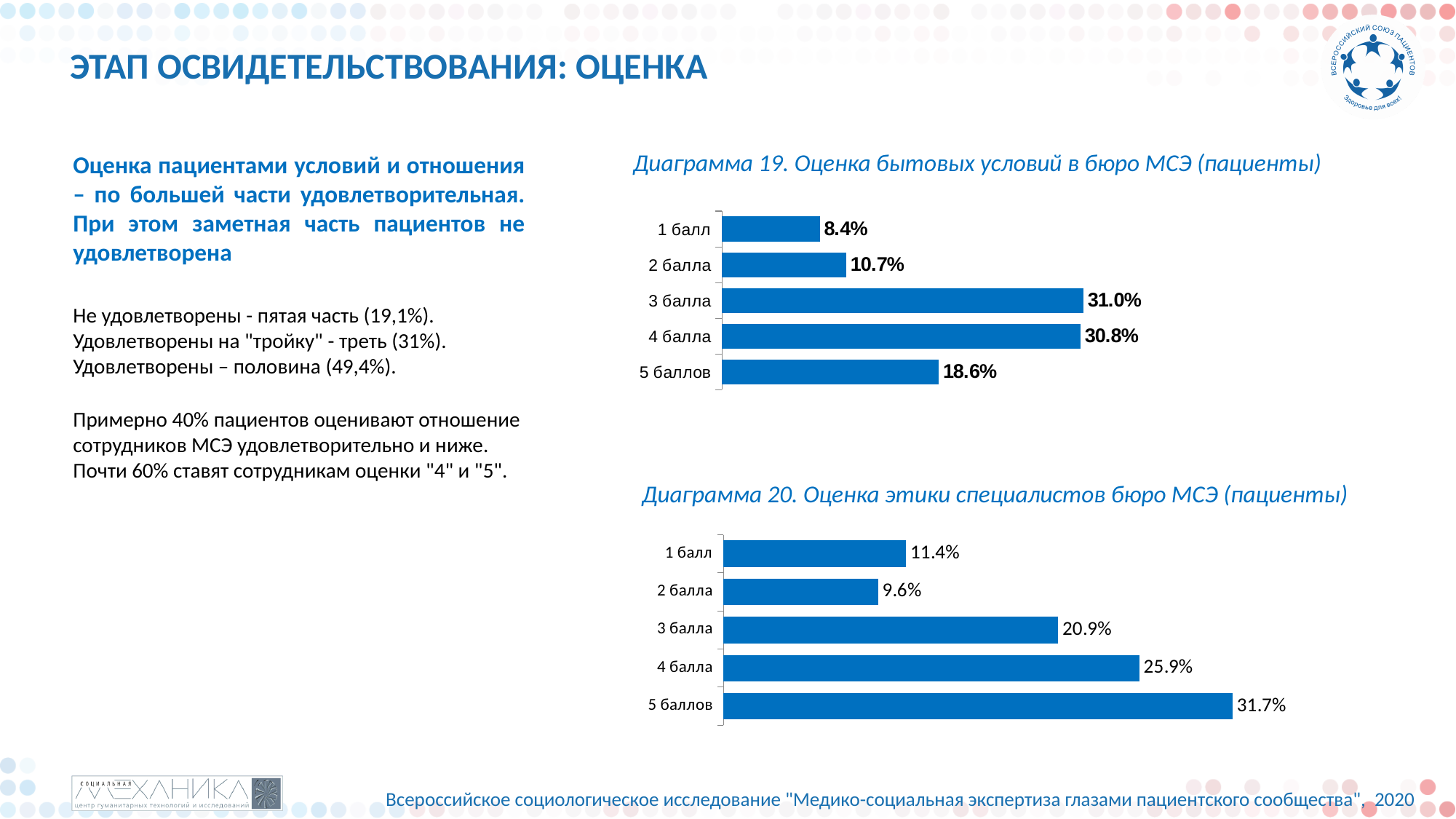
In Диаграмма 20 (Оценка этики специалистов бюро МСЭ), which category has the highest value? 5 баллов In Диаграмма 20 (Оценка этики специалистов бюро МСЭ), what is the value for 4 балла? 25.9% In Диаграмма 19 (Оценка бытовых условий в бюро МСЭ), what is the value for 3 балла? 31.0% In Диаграмма 19 (Оценка бытовых условий в бюро МСЭ), what is the difference between the values for 2 балла and 1 балл? 2.3% In Диаграмма 20 (Оценка этики специалистов бюро МСЭ), what is the value for 2 балла? 9.6% In Диаграмма 20 (Оценка этики специалистов бюро МСЭ), which category has the lowest value? 2 балла What type of chart is Диаграмма 19 (Оценка бытовых условий в бюро МСЭ)? Bar chart In Диаграмма 20 (Оценка этики специалистов бюро МСЭ), what is the difference between the values for 5 баллов and 4 балла? 5.8% In Диаграмма 19 (Оценка бытовых условий в бюро МСЭ), what is the value for 5 баллов? 18.6% In Диаграмма 20 (Оценка этики специалистов бюро МСЭ), which is larger: the value for 3 балла or the value for 1 балл? 3 балла In Диаграмма 19 (Оценка бытовых условий в бюро МСЭ), how many categories are shown? 5 In Диаграмма 19 (Оценка бытовых условий в бюро МСЭ), which category has the lowest value? 1 балл